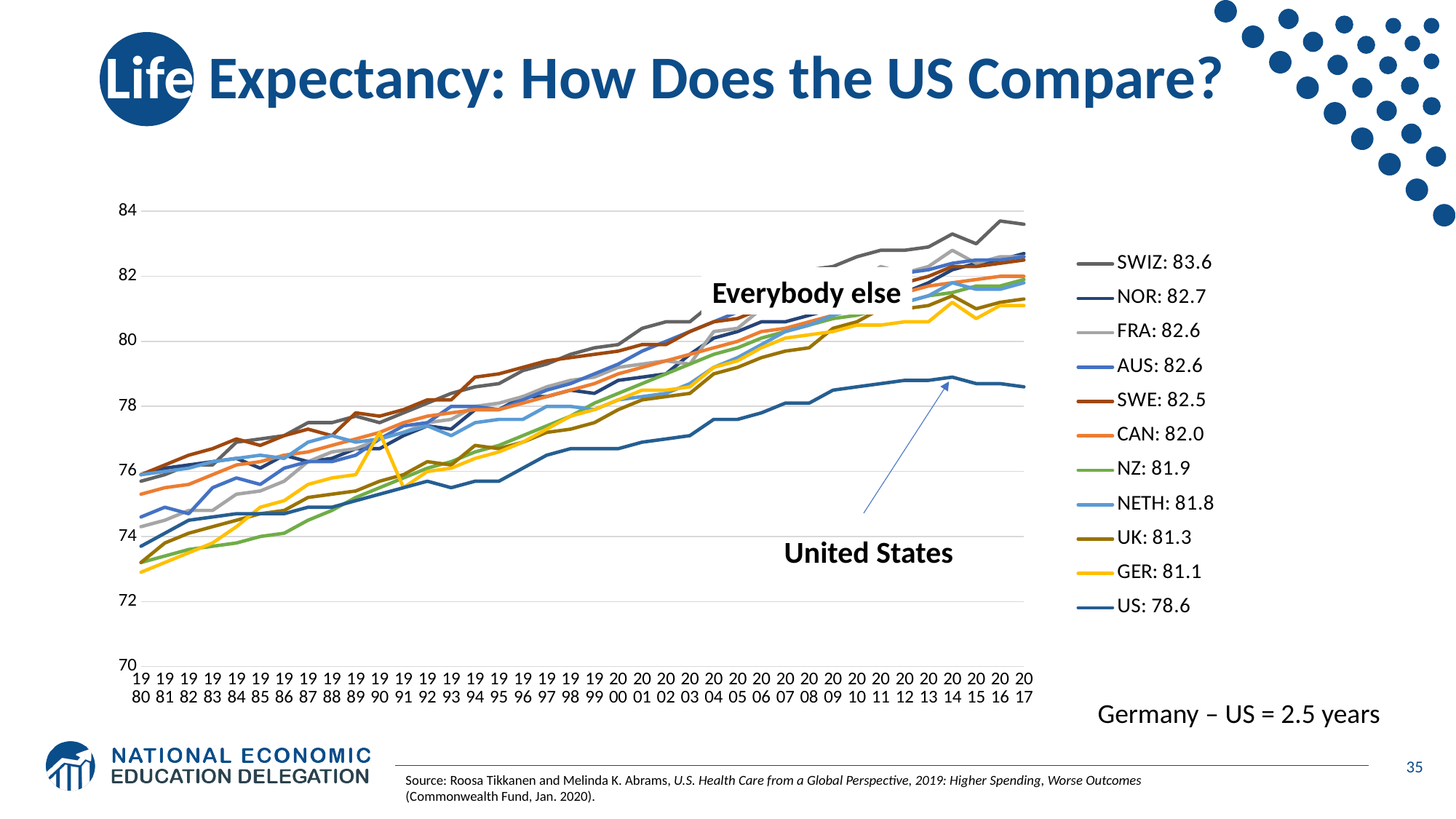
What value does the legend give for GER? 81.1 Which country has the lowest life expectancy value in the legend? US Which country has the highest life expectancy value in the legend? SWIZ Is the US value in 2000 greater or less than 78? less What is the 2017 life expectancy value shown for SWIZ in the legend? 83.6 Do the life expectancy lines generally rise or fall from 1980 to 2017? Rise What is the difference between the SWIZ value and the US value shown in the legend? 5.0 What type of chart is shown on the slide? Line chart Which has a higher legend value, NOR or CAN? NOR According to the text below the legend, what is the gap between Germany and the US? 2.5 years How many series does the legend list? 11 What is the life expectancy value shown for the US in the legend? 78.6